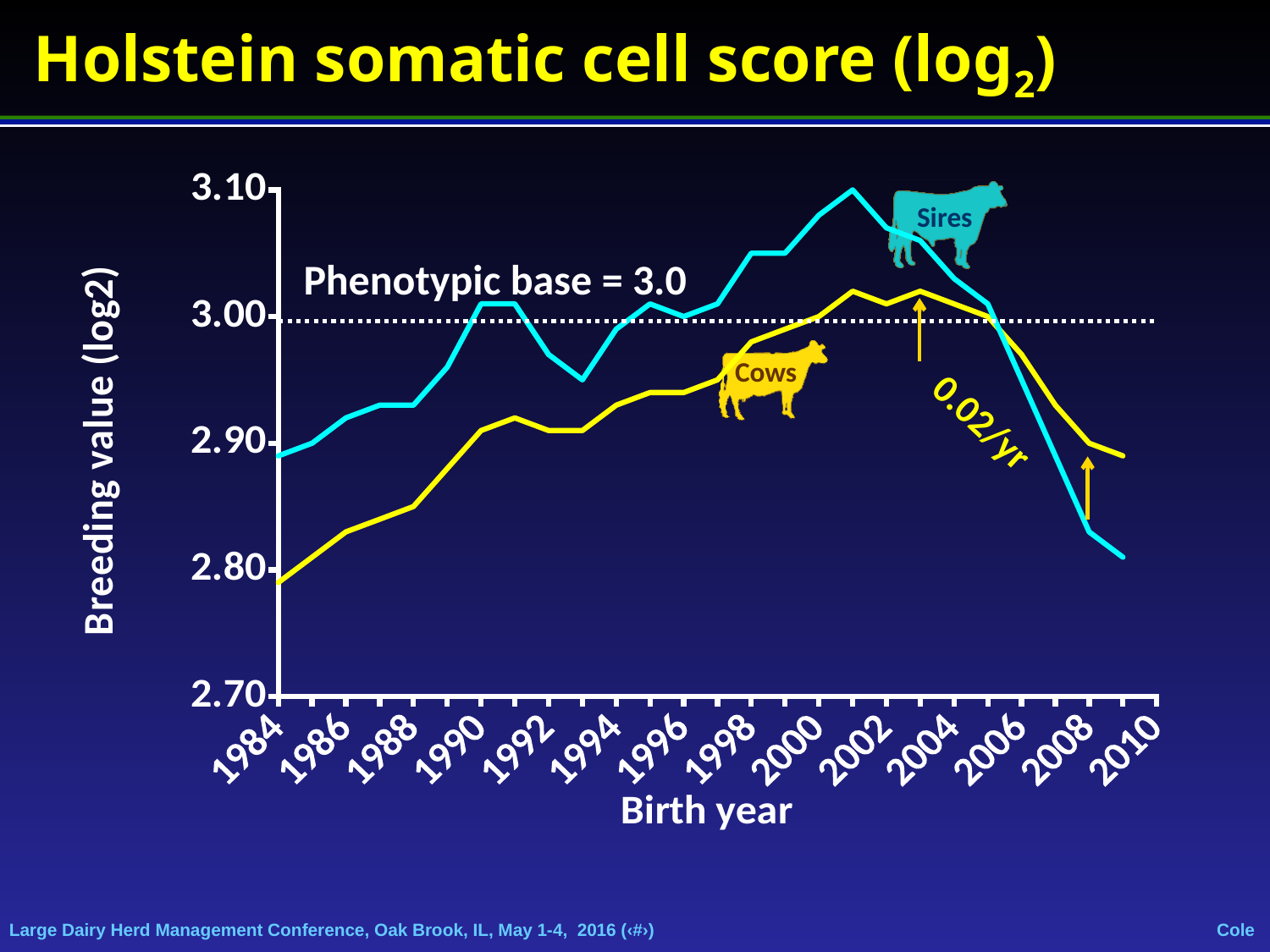
Which series has the lower breeding value in 1984, Sires or Cows? Cows Is the Cows breeding value for 1994 greater or less than 3.00? less Which series has the higher breeding value in 2002, Sires or Cows? Sires What kind of chart is shown on the slide? line chart Is the Cows breeding value for 1984 greater or less than 2.90? less Is the Sires breeding value for 2002 greater or less than 3.00? greater Does the Sires breeding value rise or fall between 2002 and 2010? fall In which birth year does the Sires line reach its highest value? 2001 What value is given for the phenotypic base shown as the dotted line? 3.0 How many data series are plotted on the chart? 2 What rate of change is annotated next to the declining lines? 0.02/yr